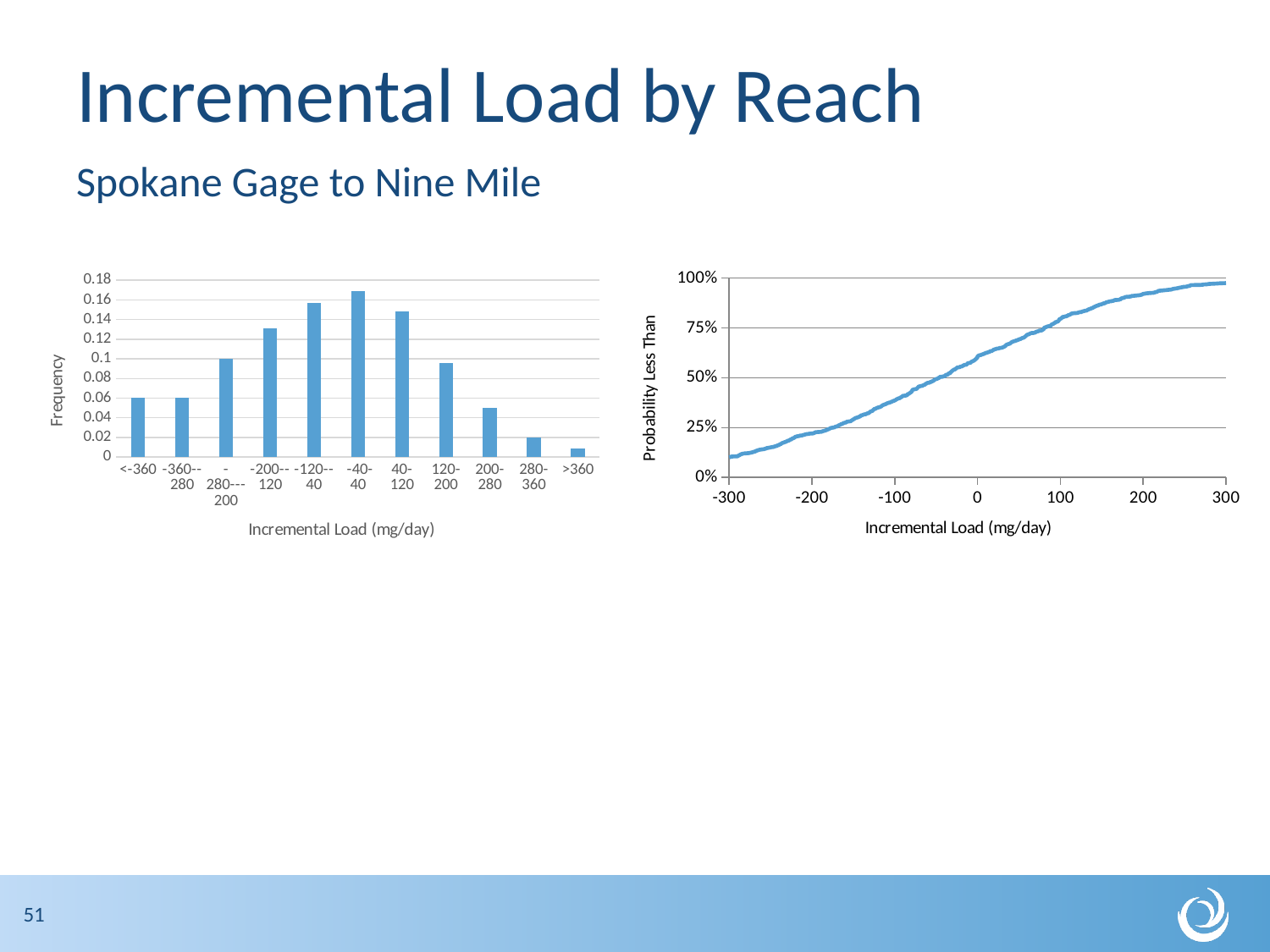
In the left bar chart, how many load bins (bars) are shown? 11 What is the y-axis label of the right line chart? Probability Less Than In the left bar chart, which bin has the larger frequency, -200--120 or 120-200? -200--120 In the left bar chart, is the frequency for the -40-40 bin greater or less than 0.16? greater In the right line chart, is the probability at an incremental load of 0 greater or less than 50%? greater In the left bar chart, which load bin has the highest frequency? -40-40 In the left bar chart, is the frequency for the 280-360 bin greater or less than 0.04? less What kind of chart is the right chart on the slide? line chart What kind of chart is the left chart on the slide? bar chart In the left bar chart, which load bin has the lowest frequency? >360 In the right line chart, does the probability rise or fall as incremental load increases from -300 to 300? rise